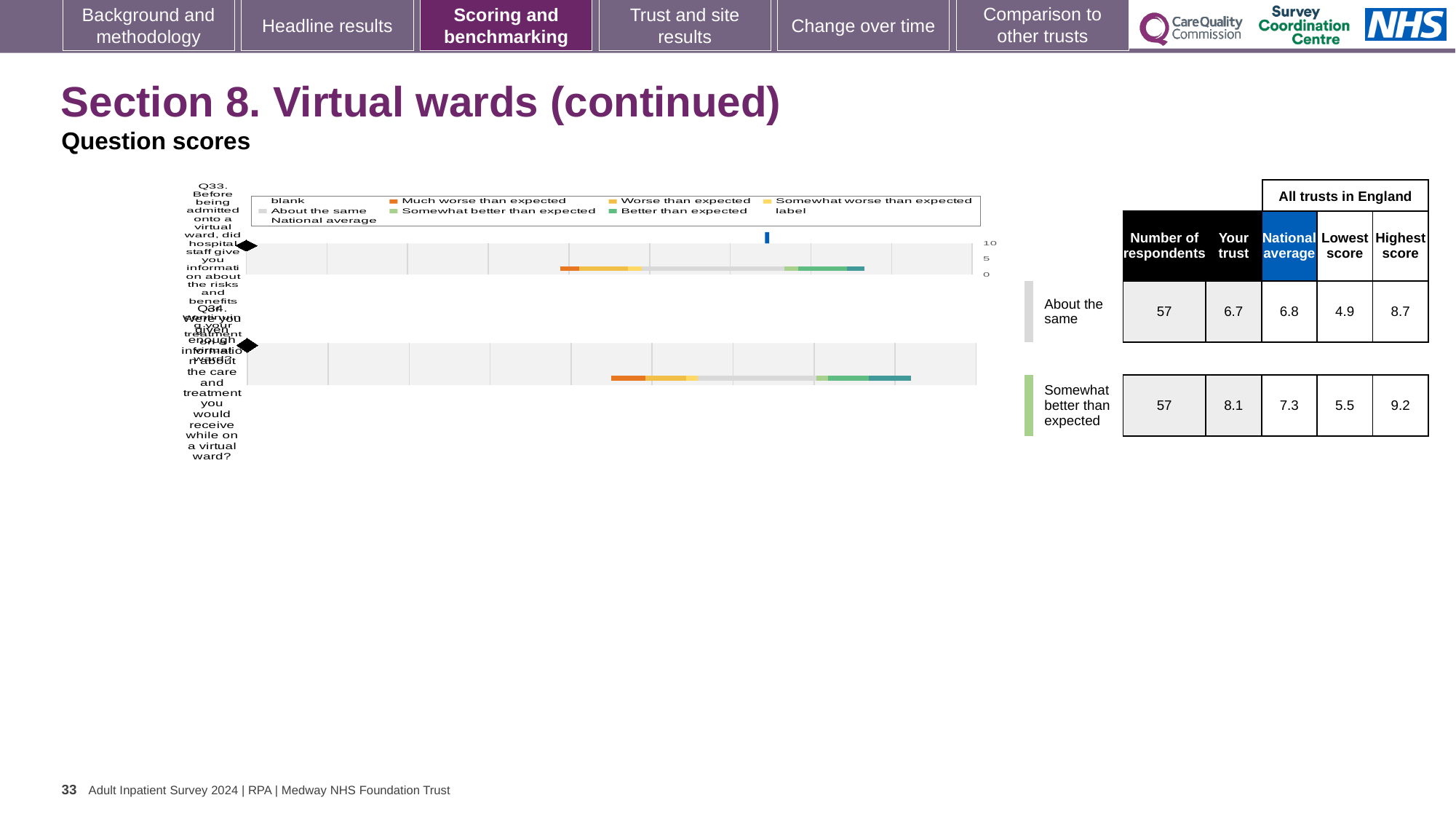
What is the highest score among all trusts in England for Q34? 9.2 What is the difference between the highest and lowest scores for Q33? 3.8 How many questions (bars) are plotted in the chart? 2 How many respondents answered Q33? 57 What is the national average score for Q33? 6.8 What is the 'Your trust' score for Q34 in the table beside the chart? 8.1 Which question has the higher 'Your trust' score, Q33 or Q34? Q34 What kind of chart is used to show the question scores for Q33 and Q34? bar chart What is the difference between the 'Your trust' score and the national average for Q34? 0.8 How many entries does the chart legend list? 9 What is the 'Your trust' score for Q33 in the table beside the chart? 6.7 Which benchmark category is Q34 placed in? Somewhat better than expected